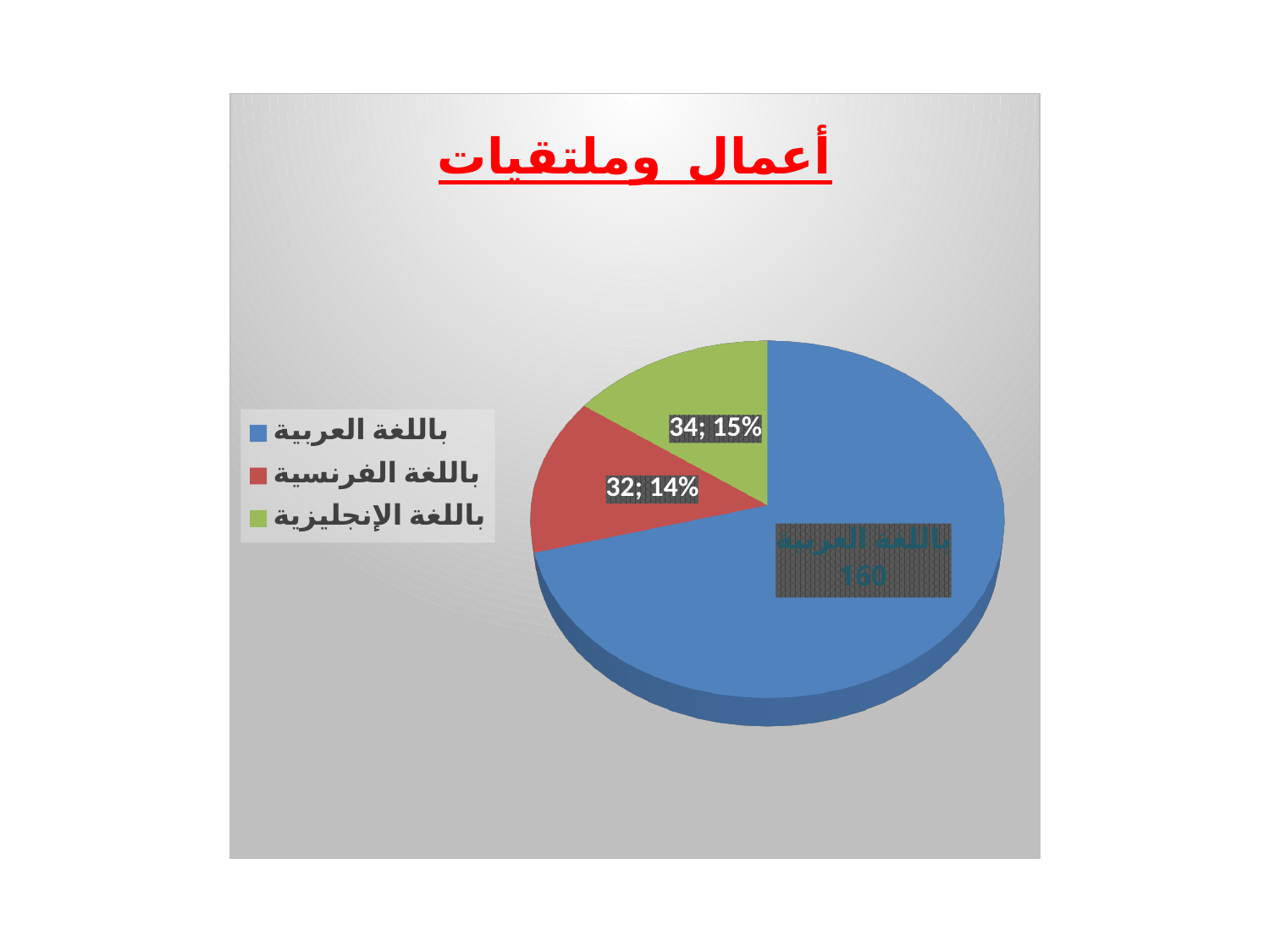
How many entries does the legend list? 3 What is the value for باللغة العربية? 160 Which category has the largest slice? باللغة العربية What is the title of the chart? أعمال وملتقيات What is the difference between the values for باللغة العربية and باللغة الفرنسية? 128 What is the value for باللغة الإنجليزية? 34 What is the value for باللغة الفرنسية? 32 What share of the pie does باللغة الإنجليزية represent? 15% What kind of chart is shown on the slide? Pie chart How many slices does the pie chart have? 3 What share of the pie does باللغة الفرنسية represent? 14% Which category has the smallest slice? باللغة الفرنسية